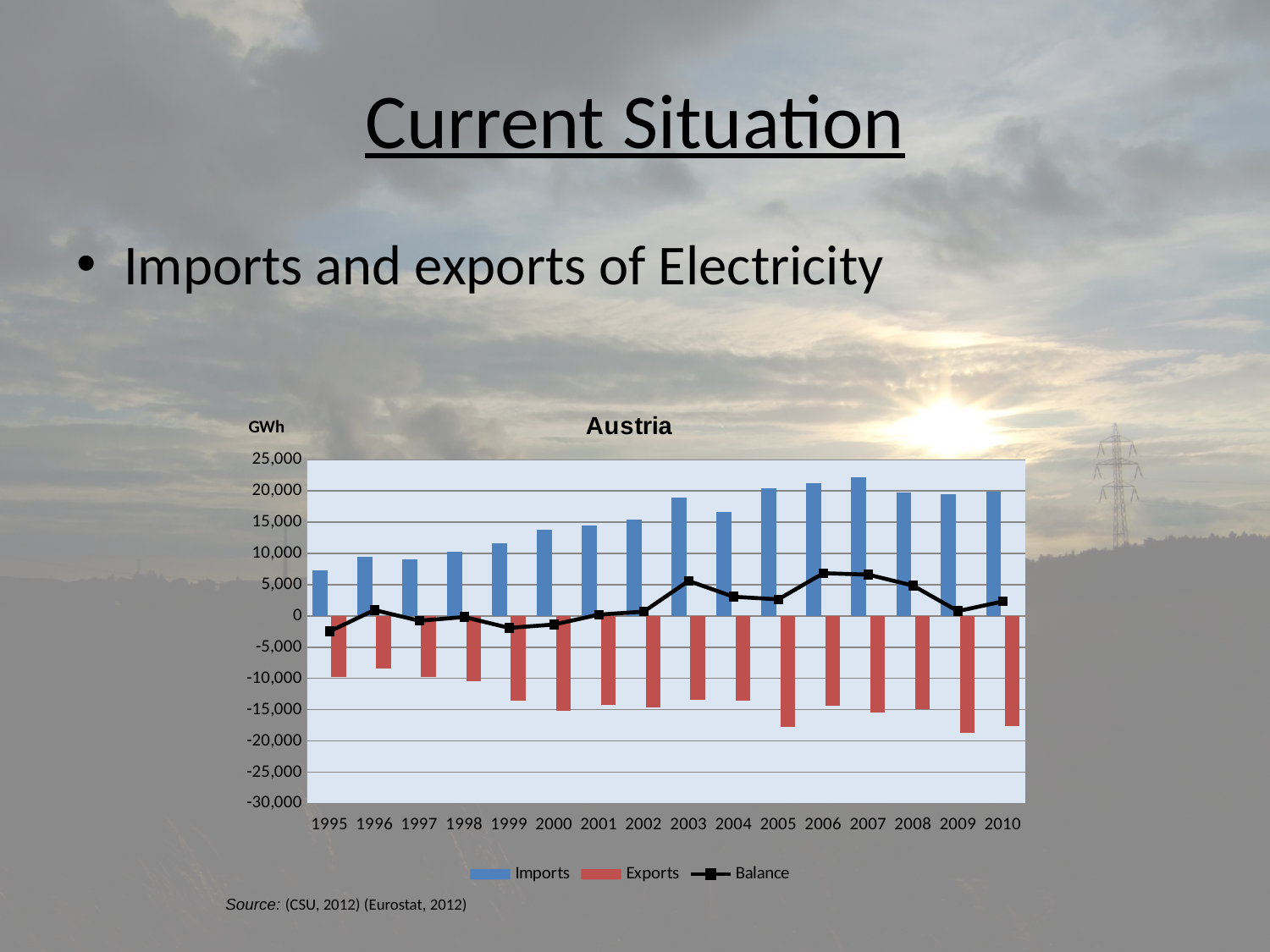
Is the value for Exports in 2009 greater or less than -15,000? less In which year are Imports highest? 2007 Is the value for Imports in 2007 greater or less than 20,000? greater In which year are Imports lowest? 1995 How many series does the legend list? 3 What kind of chart is shown on the slide? Bar chart with a line series What unit is shown at the top left of the chart's vertical axis? GWh Which is larger, Imports in 2005 or Imports in 2004? 2005 How many years are shown on the x axis? 16 Is the value for Imports in 1995 greater or less than 10,000? less In which year do Exports reach their most negative value? 2009